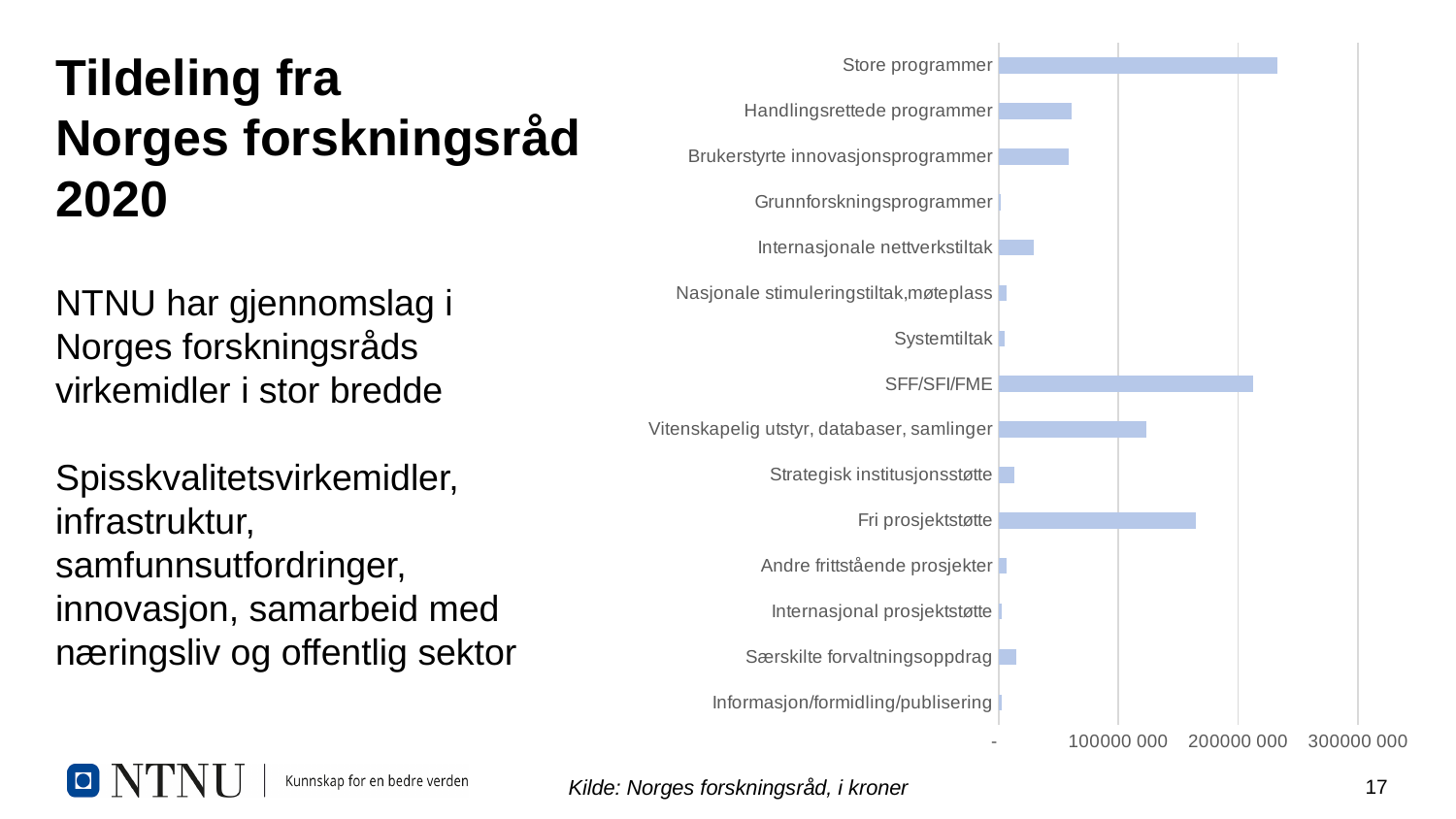
Is the value for Store programmer greater or less than 200000 000? greater What kind of chart is shown on the slide? bar chart Is the value for Fri prosjektstøtte greater or less than 200000 000? less Which is larger, the value for Store programmer or the value for Fri prosjektstøtte? Store programmer According to the source note below the chart, in what unit are the values given? kroner Is the value for Vitenskapelig utstyr, databaser, samlinger greater or less than 100000 000? greater How many categories are plotted in the bar chart? 15 Which is larger, the value for Internasjonale nettverkstiltak or the value for Systemtiltak? Internasjonale nettverkstiltak Which category has the highest value in the bar chart? Store programmer Which is larger, the value for Vitenskapelig utstyr, databaser, samlinger or the value for Handlingsrettede programmer? Vitenskapelig utstyr, databaser, samlinger